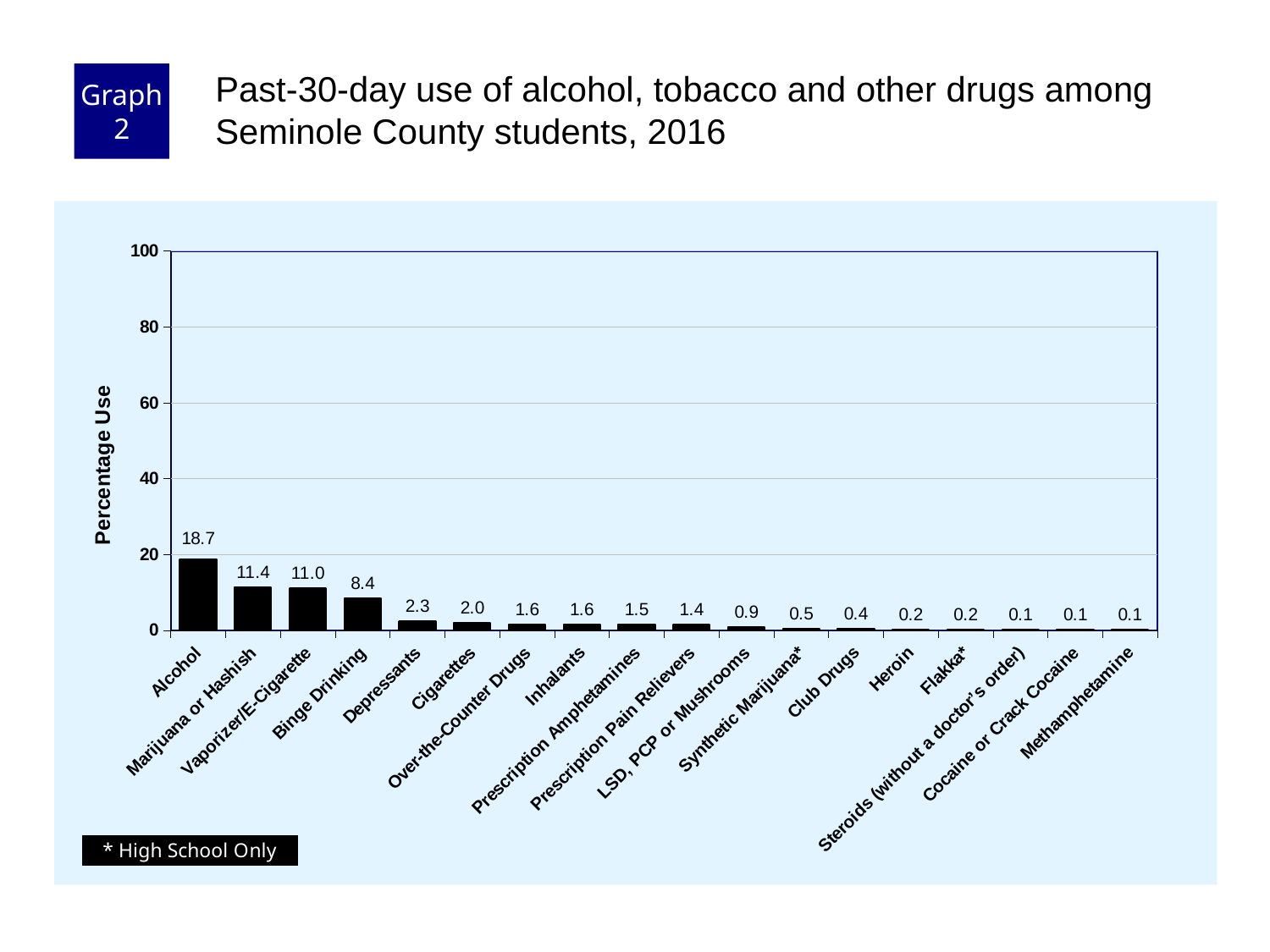
What is the difference in percentage use between Binge Drinking and Depressants? 6.1 What is the percentage use for Cigarettes? 2.0 Is the value for Alcohol greater or less than 20? less What is the difference in percentage use between Alcohol and Marijuana or Hashish? 7.3 What is the percentage use for Binge Drinking? 8.4 What kind of chart is shown on the slide? bar chart Which has a higher percentage use, Vaporizer/E-Cigarette or Binge Drinking? Vaporizer/E-Cigarette Which category has the highest percentage use? Alcohol What is the label of the y axis? Percentage Use How many categories are shown on the x axis? 18 What is the percentage use for Heroin? 0.2 What is the percentage use for Alcohol? 18.7